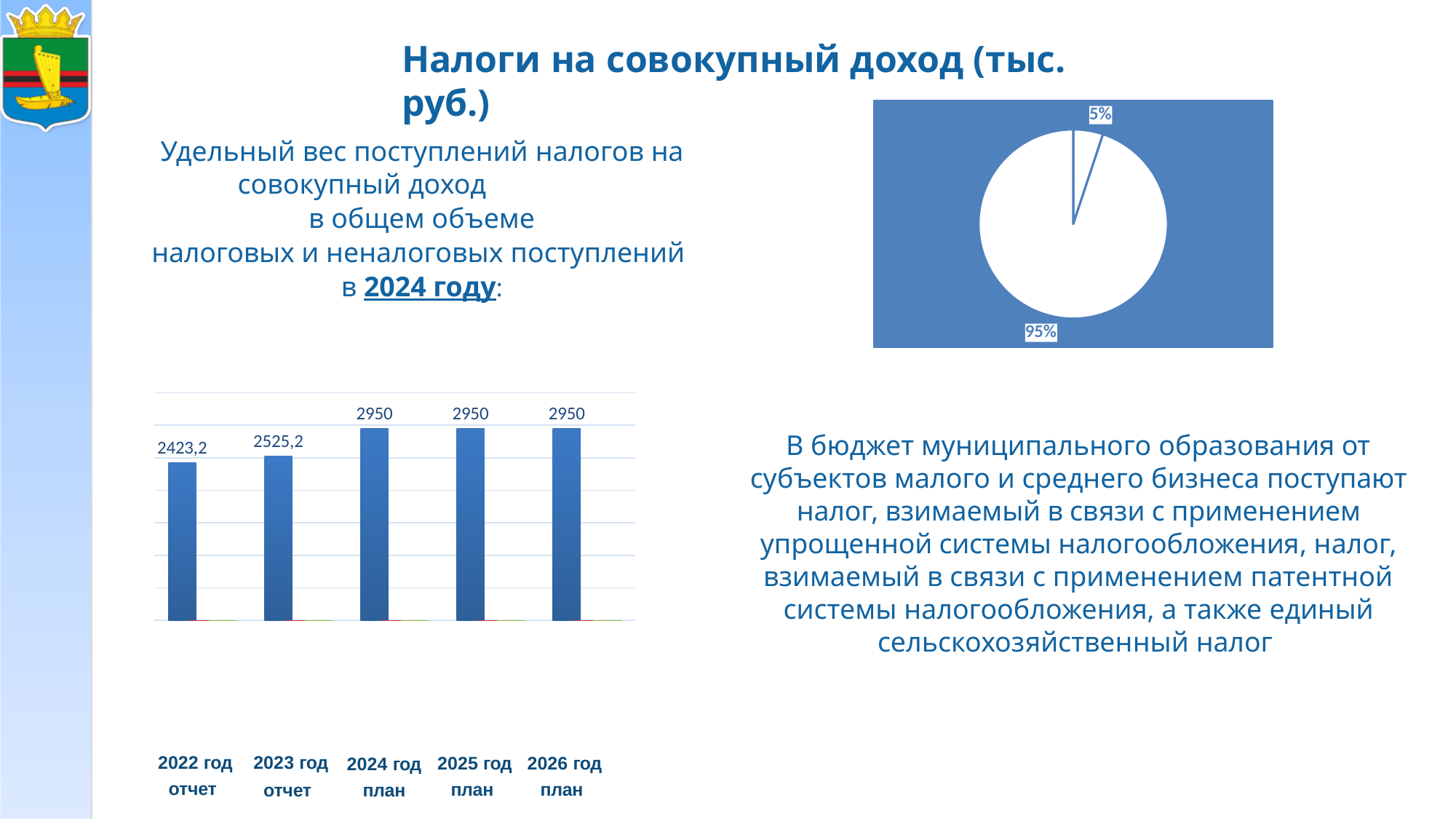
On the bar chart at the bottom left, which category has the lowest value? 2022 год отчет On the bar chart at the bottom left, what is the value for 2023 год отчет? 2525,2 On the bar chart at the bottom left, what is the value for 2026 год план? 2950 On the bar chart at the bottom left, what is the value for 2024 год план? 2950 On the bar chart at the bottom left, which is larger: the value for 2022 год отчет or 2023 год отчет? 2023 год отчет On the bar chart at the bottom left, how many categories are shown on the x axis? 5 On the bar chart at the bottom left, what is the difference between the values for 2023 год отчет and 2022 год отчет? 102 On the bar chart at the bottom left, do the values rise or fall from 2022 год отчет to 2024 год план? rise On the bar chart at the bottom left, what is the difference between the values for 2024 год план and 2023 год отчет? 424,8 On the bar chart at the bottom left, what is the value for 2022 год отчет? 2423,2 What kind of chart is shown at the top right of the slide? pie chart On the pie chart at the top right, what share does the larger slice have? 95%